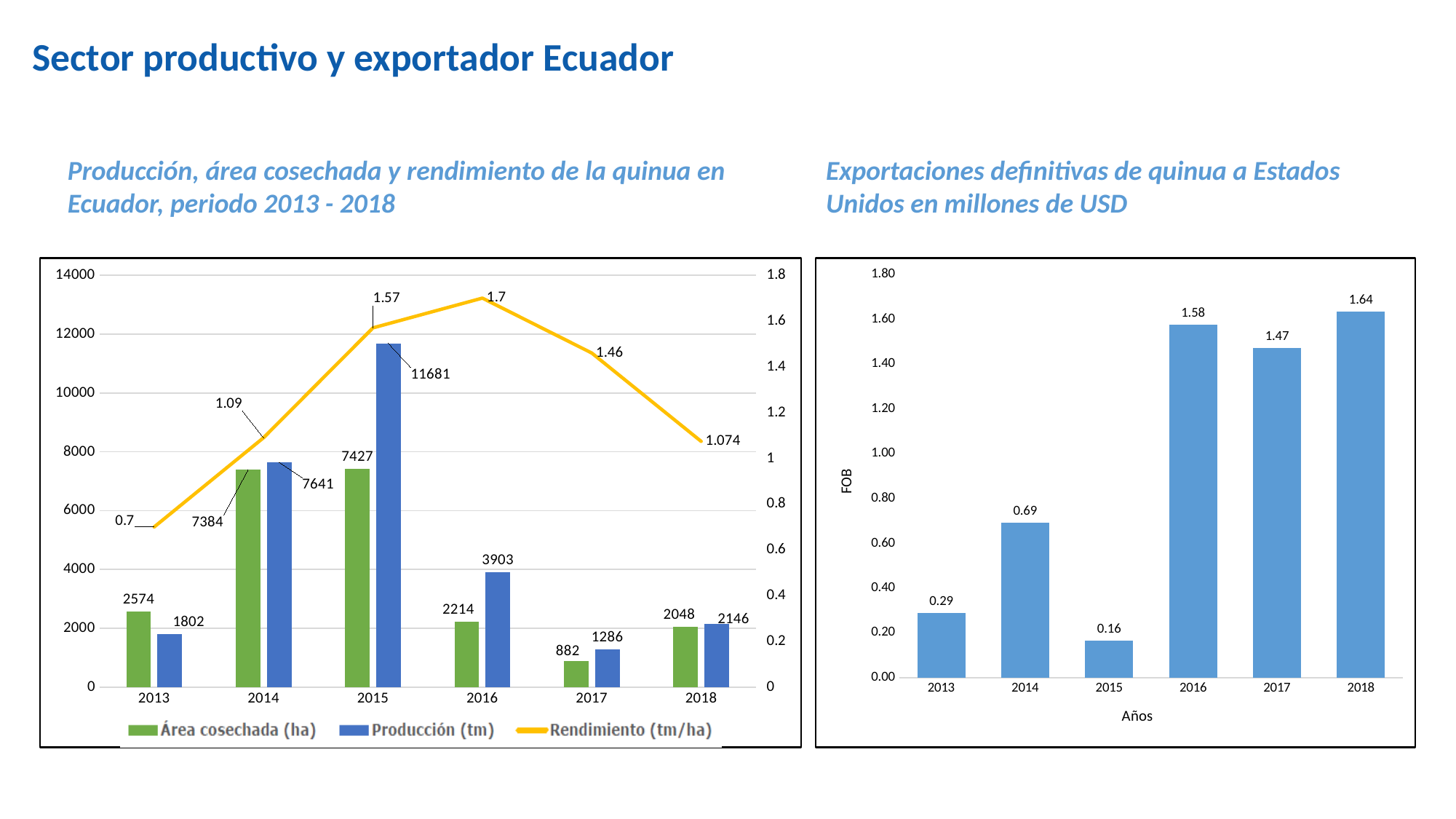
In the right chart (Exportaciones definitivas de quinua a Estados Unidos), what is the FOB value for 2014? 0.69 In the left chart (Producción, área cosechada y rendimiento de la quinua en Ecuador), what is the difference between Producción (tm) and Área cosechada (ha) in 2016? 1689 In the left chart (Producción, área cosechada y rendimiento de la quinua en Ecuador), which year has the highest Producción (tm)? 2015 In the left chart (Producción, área cosechada y rendimiento de la quinua en Ecuador), what is the Área cosechada (ha) value for 2017? 882 In the right chart (Exportaciones definitivas de quinua a Estados Unidos), what is the difference between the 2018 and 2013 values? 1.35 In the left chart (Producción, área cosechada y rendimiento de la quinua en Ecuador), how many series does the legend list? 3 In the right chart (Exportaciones definitivas de quinua a Estados Unidos), which year has the lowest value? 2015 In the left chart (Producción, área cosechada y rendimiento de la quinua en Ecuador), what is the Rendimiento (tm/ha) value for 2018? 1.074 In the right chart (Exportaciones definitivas de quinua a Estados Unidos), which year has the highest value? 2018 What kind of chart is the right chart (Exportaciones definitivas de quinua a Estados Unidos)? Bar chart In the left chart (Producción, área cosechada y rendimiento de la quinua en Ecuador), what is the Producción (tm) value for 2015? 11681 In the left chart (Producción, área cosechada y rendimiento de la quinua en Ecuador), which year has the lowest Área cosechada (ha)? 2017